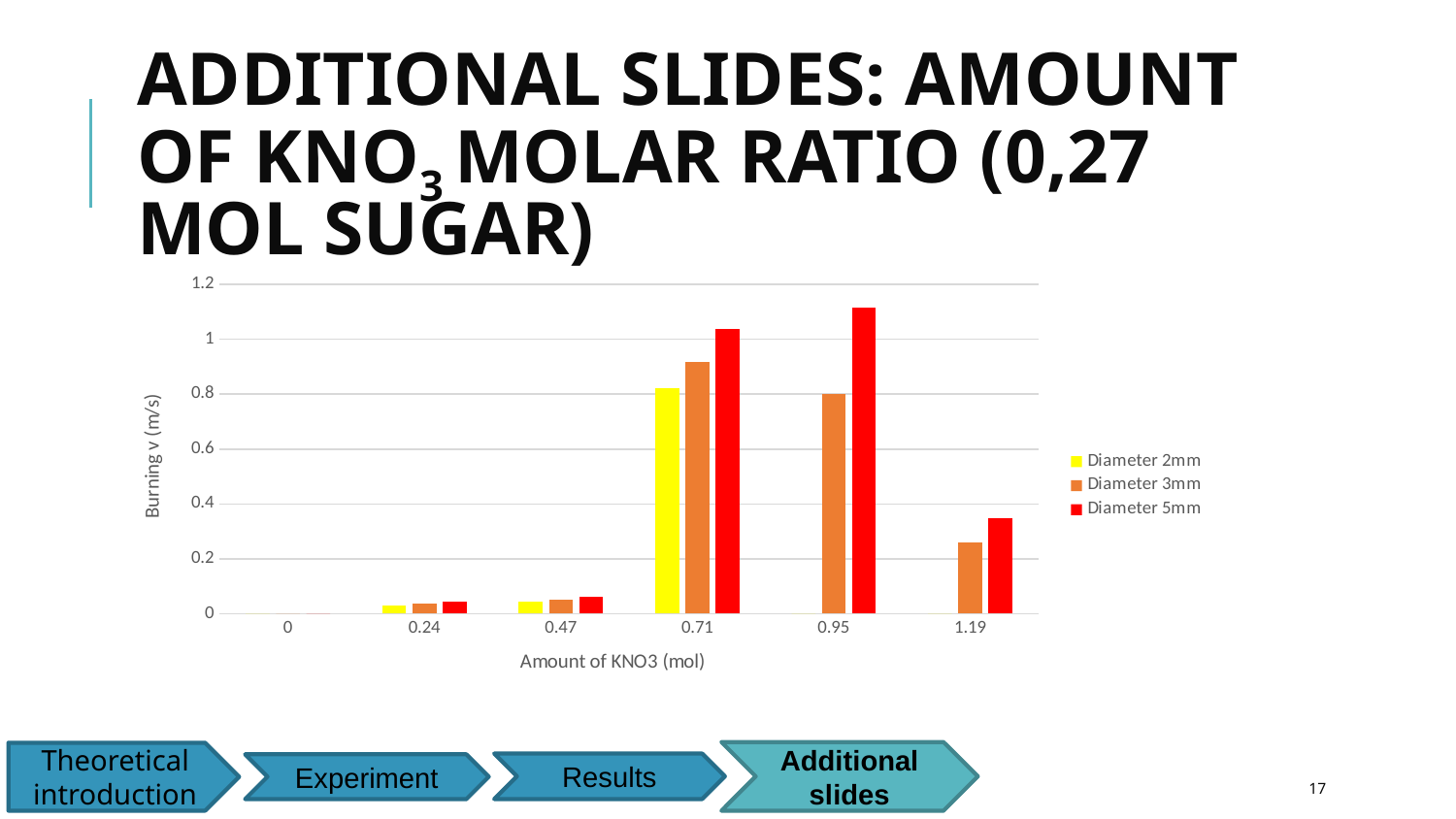
Is the value for Diameter 5mm at 0.95 mol greater or less than 1? greater Which amount of KNO3 has the tallest bar for Diameter 5mm? 0.95 Is the value for Diameter 5mm at 1.19 mol greater or less than 0.4? less Which colour represents Diameter 5mm in the legend? red Which is larger for Diameter 3mm: the value at 0.71 mol or at 0.95 mol? 0.71 mol Is the value for Diameter 2mm at 0.71 mol greater or less than 0.6? greater How many categories are shown on the x axis? 6 What kind of chart is shown on the slide? bar chart How many series does the legend list? 3 What is the title of the y axis? Burning v (m/s)